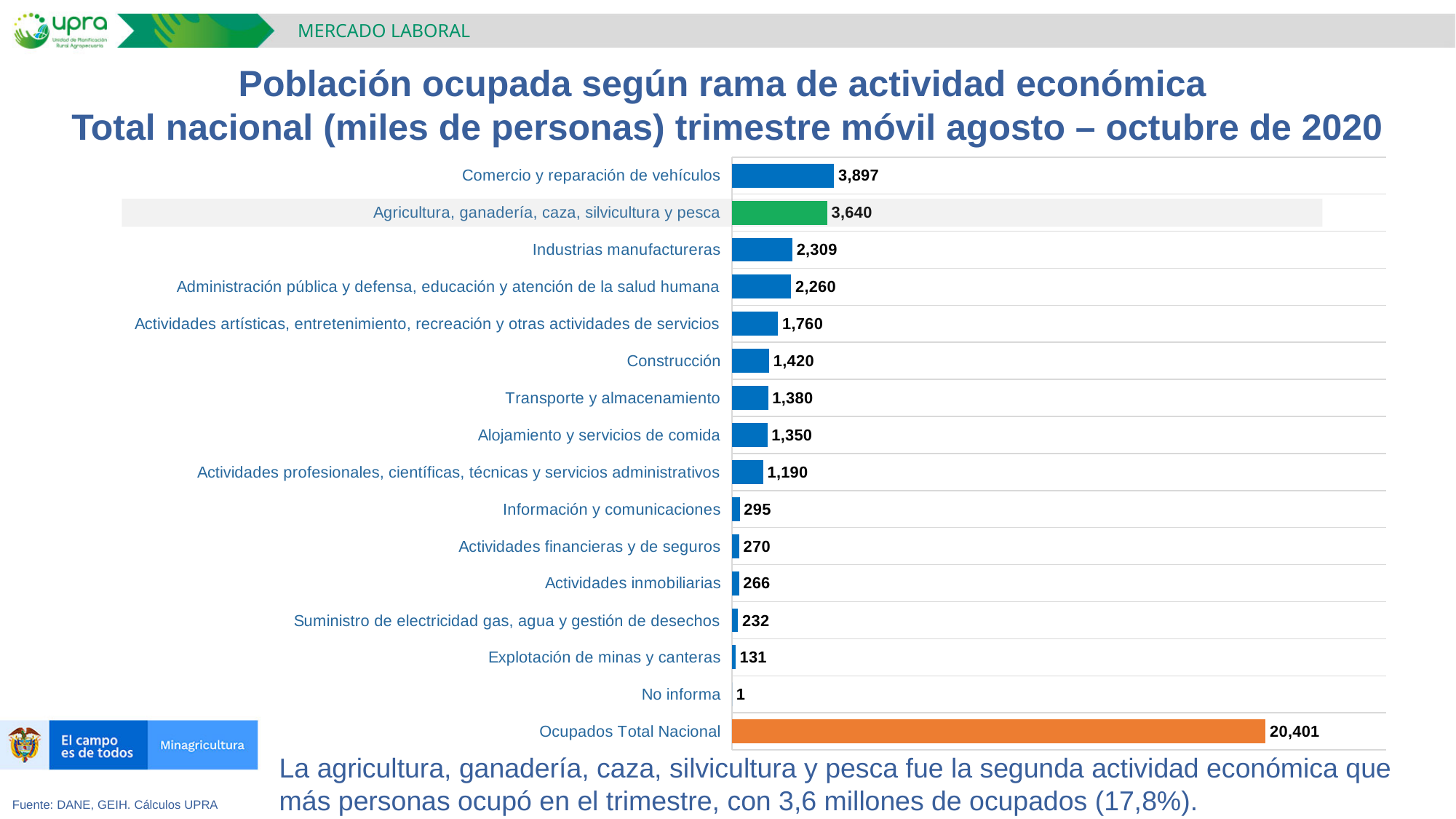
What is the value for Comercio y reparación de vehículos? 3,897 Which category has the lowest value? No informa Which is larger, Transporte y almacenamiento or Alojamiento y servicios de comida? Transporte y almacenamiento What is the difference between Comercio y reparación de vehículos and Agricultura, ganadería, caza, silvicultura y pesca? 257 What is the difference between Industrias manufactureras and Administración pública y defensa, educación y atención de la salud humana? 49 What is the value for Construcción? 1,420 What colour is the bar for Agricultura, ganadería, caza, silvicultura y pesca? Green What is the value for Agricultura, ganadería, caza, silvicultura y pesca? 3,640 How many bars are plotted in the chart? 16 What kind of chart is shown on the slide? Bar chart Excluding Ocupados Total Nacional, which economic activity has the highest value? Comercio y reparación de vehículos What is the value for Ocupados Total Nacional? 20,401